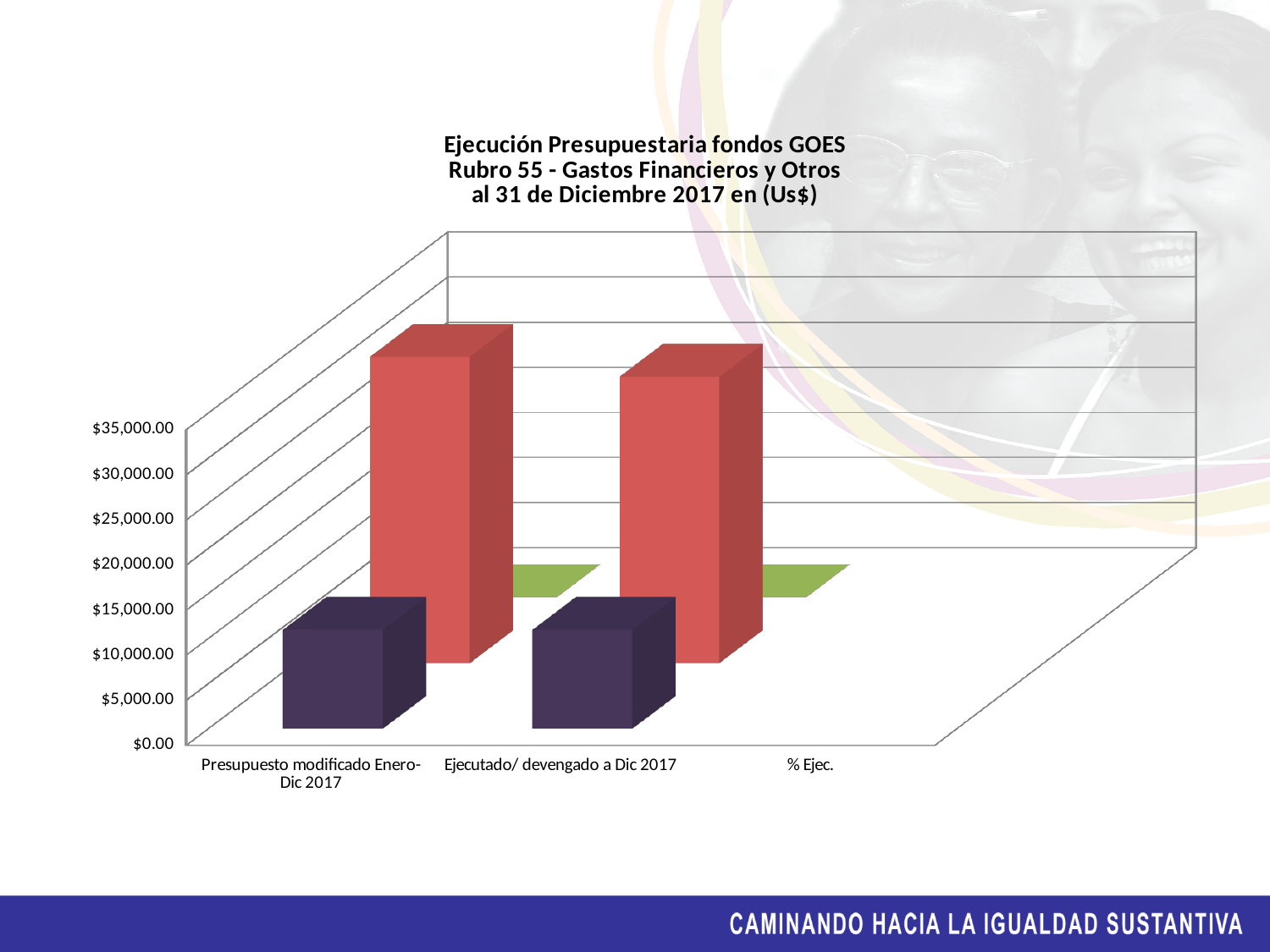
What is the highest value labelled on the vertical axis of the chart? $35,000.00 Is the value of the dark purple bar for 'Ejecutado/ devengado a Dic 2017' greater or less than $20,000.00? less What is the title of the chart? Ejecución Presupuestaria fondos GOES Rubro 55 - Gastos Financieros y Otros al 31 de Diciembre 2017 en (Us$) Is the value of the tall red bar for 'Ejecutado/ devengado a Dic 2017' greater or less than $20,000.00? greater Is the value of the dark purple bar for 'Presupuesto modificado Enero-Dic 2017' greater or less than $20,000.00? less Which category on the x axis has no tall red bar? % Ejec. How many categories are shown on the x axis of the chart? 3 What kind of chart is shown on the slide? bar chart Which red bar is taller: the one for 'Presupuesto modificado Enero-Dic 2017' or the one for 'Ejecutado/ devengado a Dic 2017'? Presupuesto modificado Enero-Dic 2017